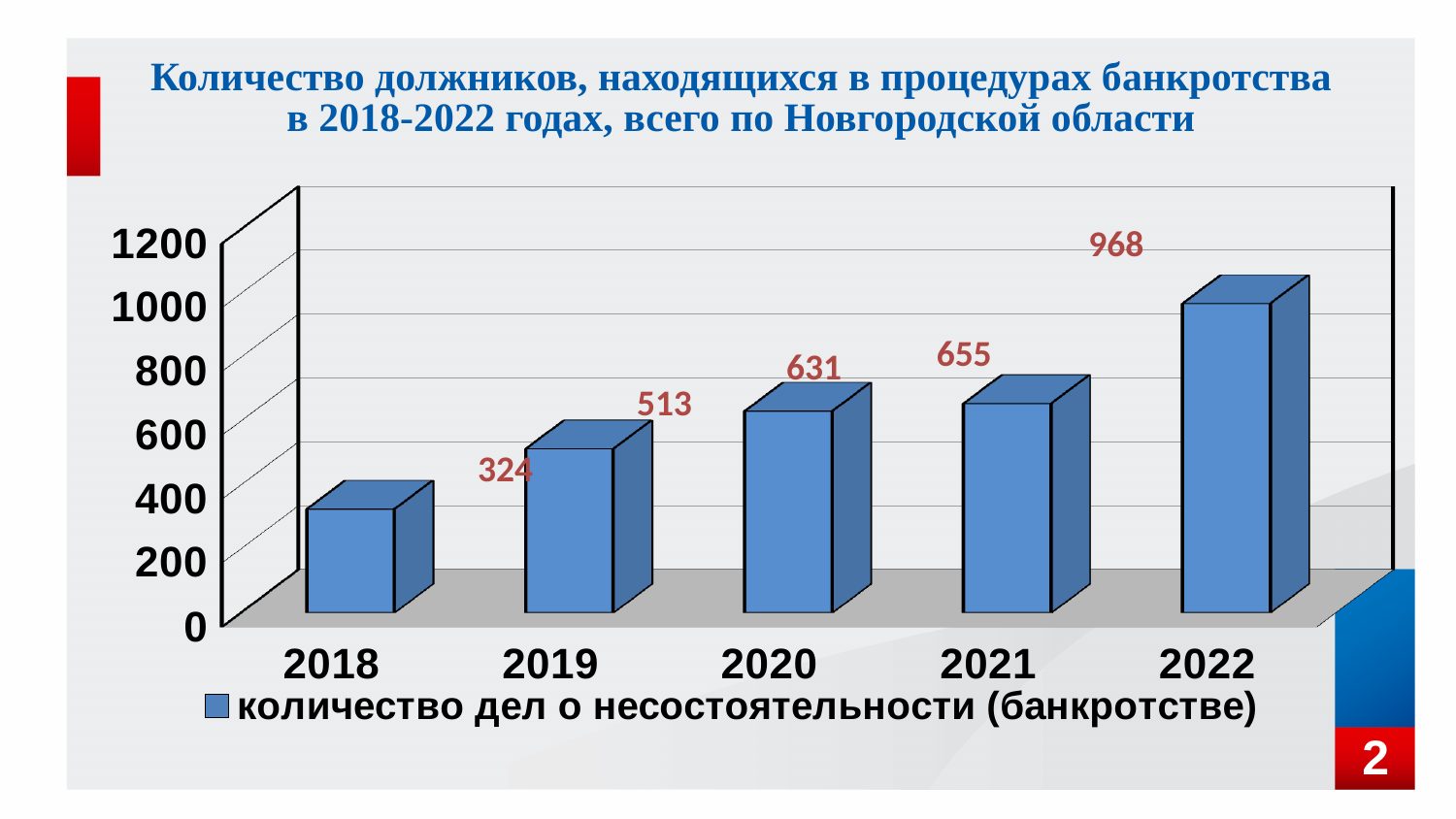
Which year has the highest value? 2022 What is the value for 2022? 968 Which year has the lowest value? 2018 Do the values rise or fall from 2018 to 2022? rise Is the value for 2022 greater or less than 800? greater What kind of chart is shown on the slide? bar chart What is the difference between the values for 2022 and 2021? 313 What is the value for 2020? 631 How many years are shown on the x axis? 5 What is the difference between the values for 2019 and 2018? 189 What is the value for 2018? 324 Which is larger, the value for 2019 or the value for 2021? 2021